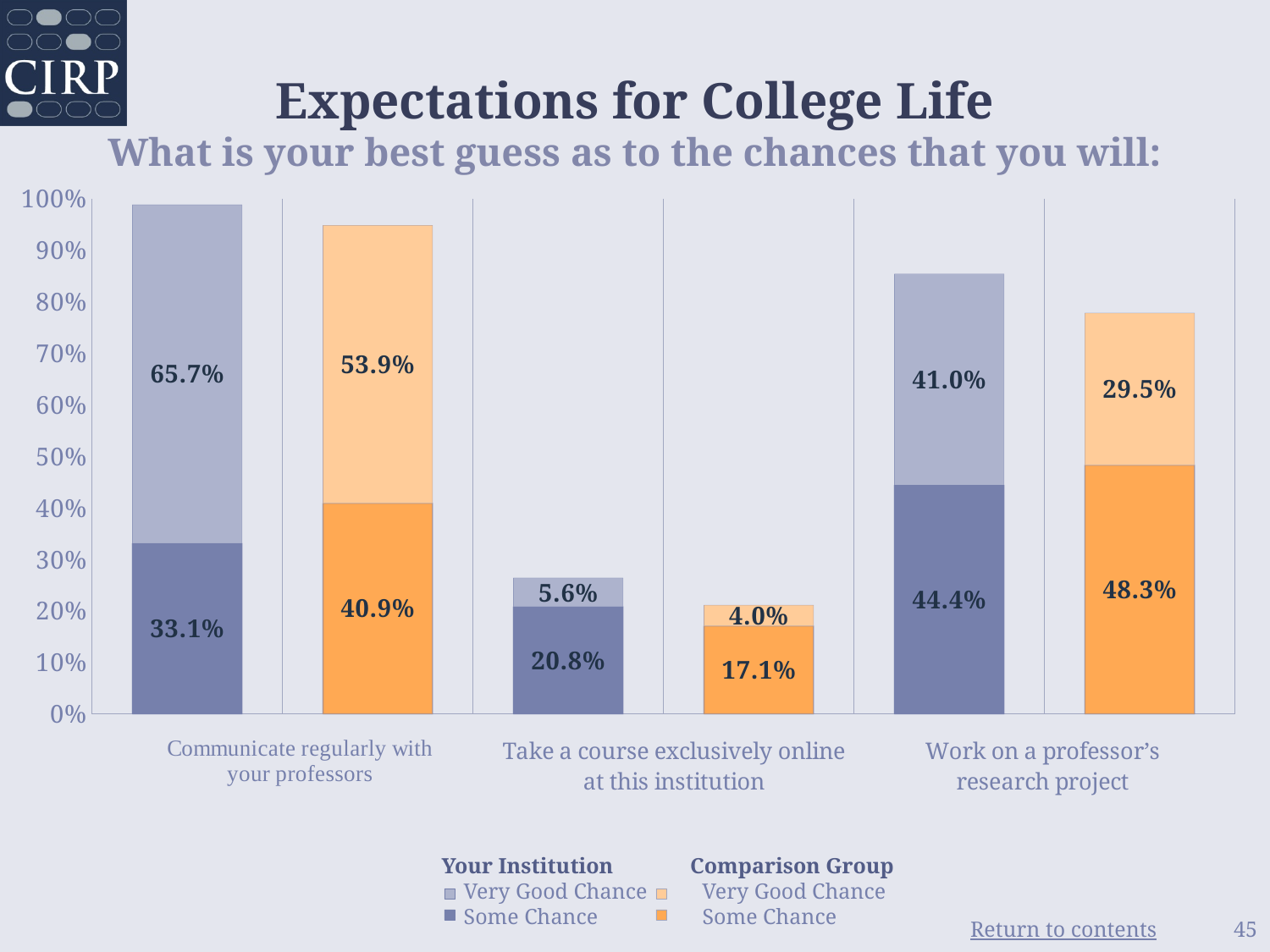
What is the total of the stacked bar for Your Institution for 'Take a course exclusively online at this institution'? 26.4% For 'Communicate regularly with your professors', which is larger: the Your Institution 'Some Chance' value or the Comparison Group 'Some Chance' value? Comparison Group What is the 'Some Chance' value for the Comparison Group for 'Work on a professor's research project'? 48.3% How many entries does the legend list? 4 What is the 'Very Good Chance' value for Your Institution for 'Communicate regularly with your professors'? 65.7% What kind of chart is shown on the slide? Stacked bar chart What is the total of the stacked bar for the Comparison Group for 'Work on a professor's research project'? 77.8% What is the difference between the Your Institution and Comparison Group 'Very Good Chance' values for 'Work on a professor's research project'? 11.5% Which category has the highest 'Some Chance' value for the Comparison Group? Work on a professor's research project How many categories are shown on the x axis? 3 Which category has the lowest 'Very Good Chance' value for Your Institution? Take a course exclusively online at this institution What is the 'Very Good Chance' value for the Comparison Group for 'Take a course exclusively online at this institution'? 4.0%